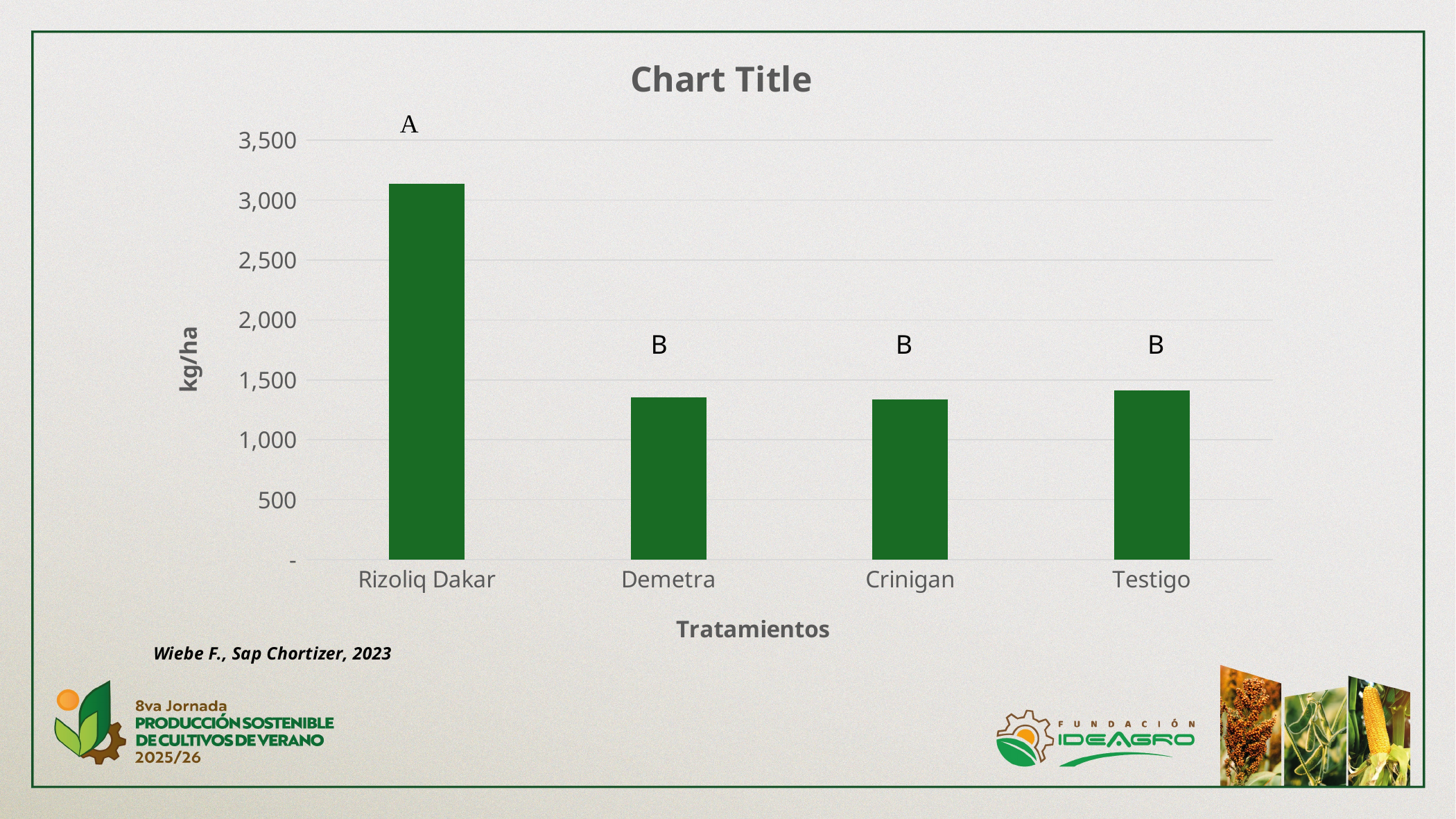
How many treatments (categories) are plotted on the x axis? 4 What letter is printed above the Rizoliq Dakar bar? A Is the value for Demetra greater or less than 1,500? less What kind of chart is shown on the slide? bar chart Is the value for Testigo greater or less than 1,500? less Which treatment has the highest value? Rizoliq Dakar What is the label on the y axis? kg/ha Which is larger, the value for Rizoliq Dakar or the value for Testigo? Rizoliq Dakar Is the value for Rizoliq Dakar greater or less than 3,000? greater Which is larger, the value for Demetra or the value for Rizoliq Dakar? Rizoliq Dakar